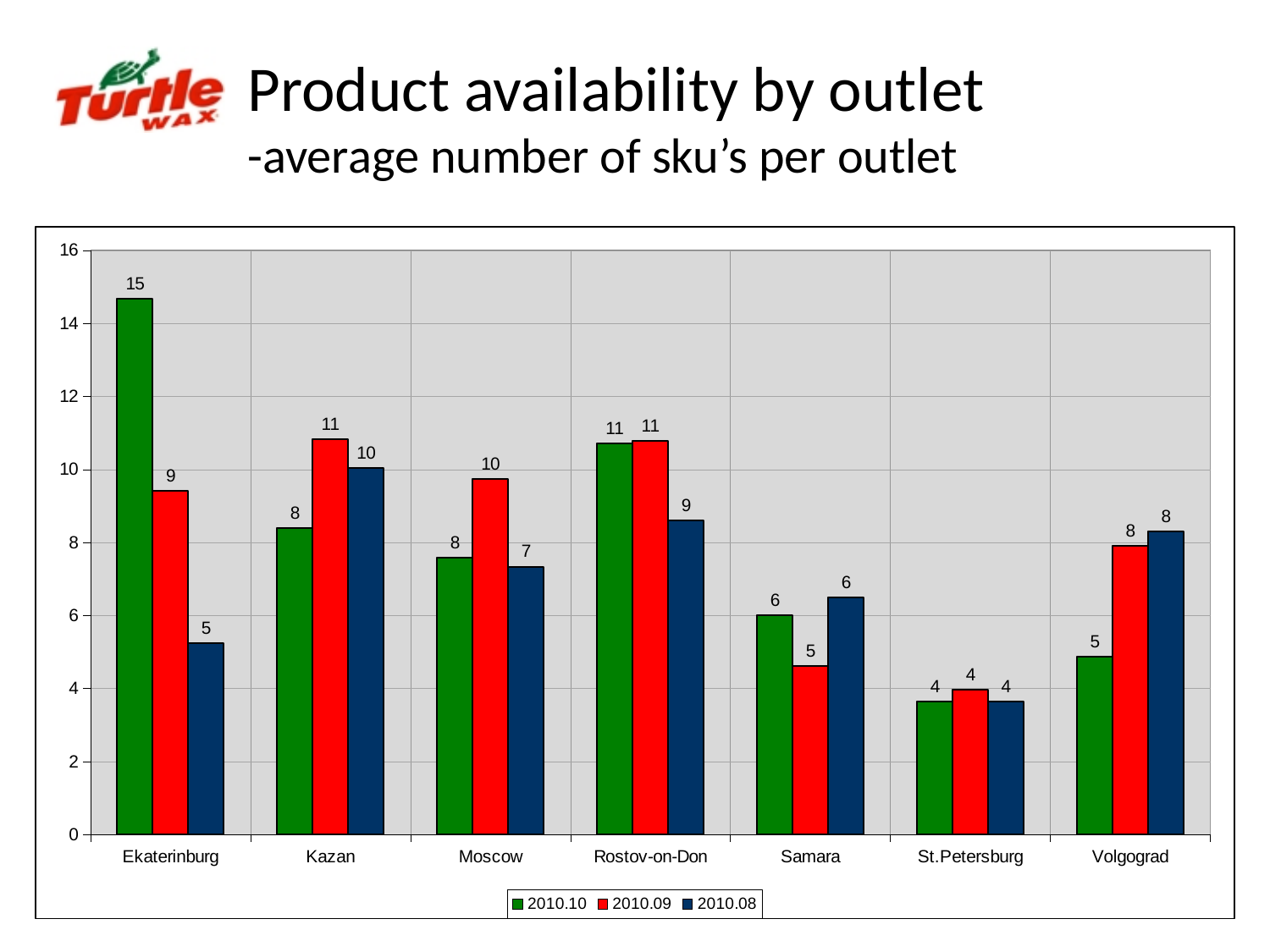
What is the difference between the 2010.10 and 2010.08 values for Ekaterinburg? 10 How many series does the legend list? 3 What is the value for Moscow in the 2010.09 series? 10 Which outlet has the highest value in the 2010.10 series? Ekaterinburg What is the value for Ekaterinburg in the 2010.10 series? 15 How many outlets are shown on the x axis? 7 What kind of chart is shown on the slide? bar chart What is the value for Volgograd in the 2010.08 series? 8 Which outlet has the lowest value in the 2010.10 series? St.Petersburg For Kazan, which is larger: the 2010.09 value or the 2010.10 value? 2010.09 Is the value for Ekaterinburg in the 2010.10 series greater or less than 14? greater What colour represents the 2010.08 series in the legend? dark blue